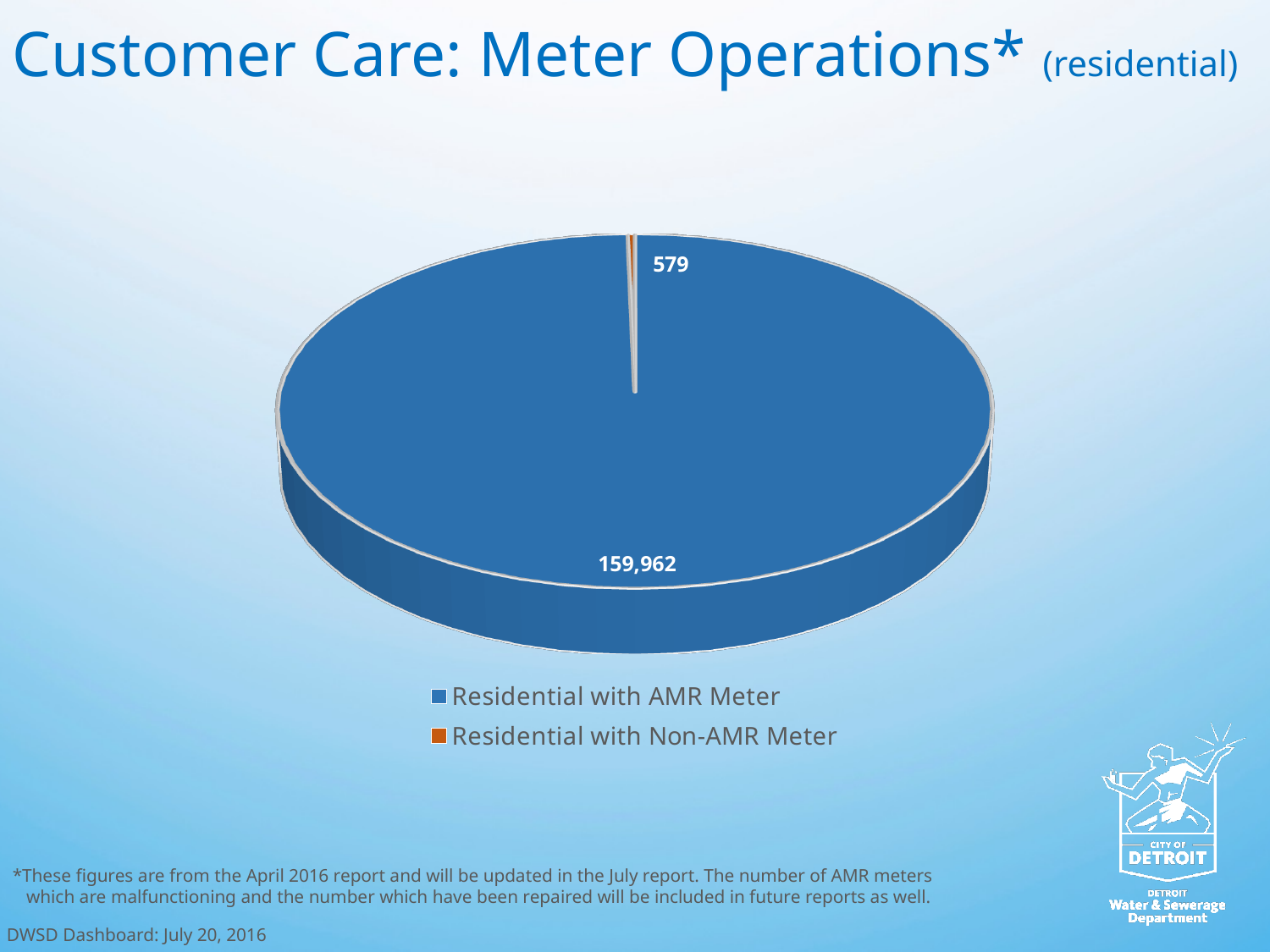
What is the value for Residential with AMR Meter? 159,962 Which category has the largest slice of the pie? Residential with AMR Meter How many entries does the legend list? 2 Which is larger, Residential with AMR Meter or Residential with Non-AMR Meter? Residential with AMR Meter What kind of chart is shown on the slide? pie chart What is the title of the slide containing the chart? Customer Care: Meter Operations* (residential) How many slices does the pie chart have? 2 What is the total of the two values shown in the pie chart? 160,541 What is the difference between the Residential with AMR Meter value and the Residential with Non-AMR Meter value? 159,383 What is the value for Residential with Non-AMR Meter? 579 Which category has the smallest slice of the pie? Residential with Non-AMR Meter What colour is the Residential with AMR Meter slice? blue